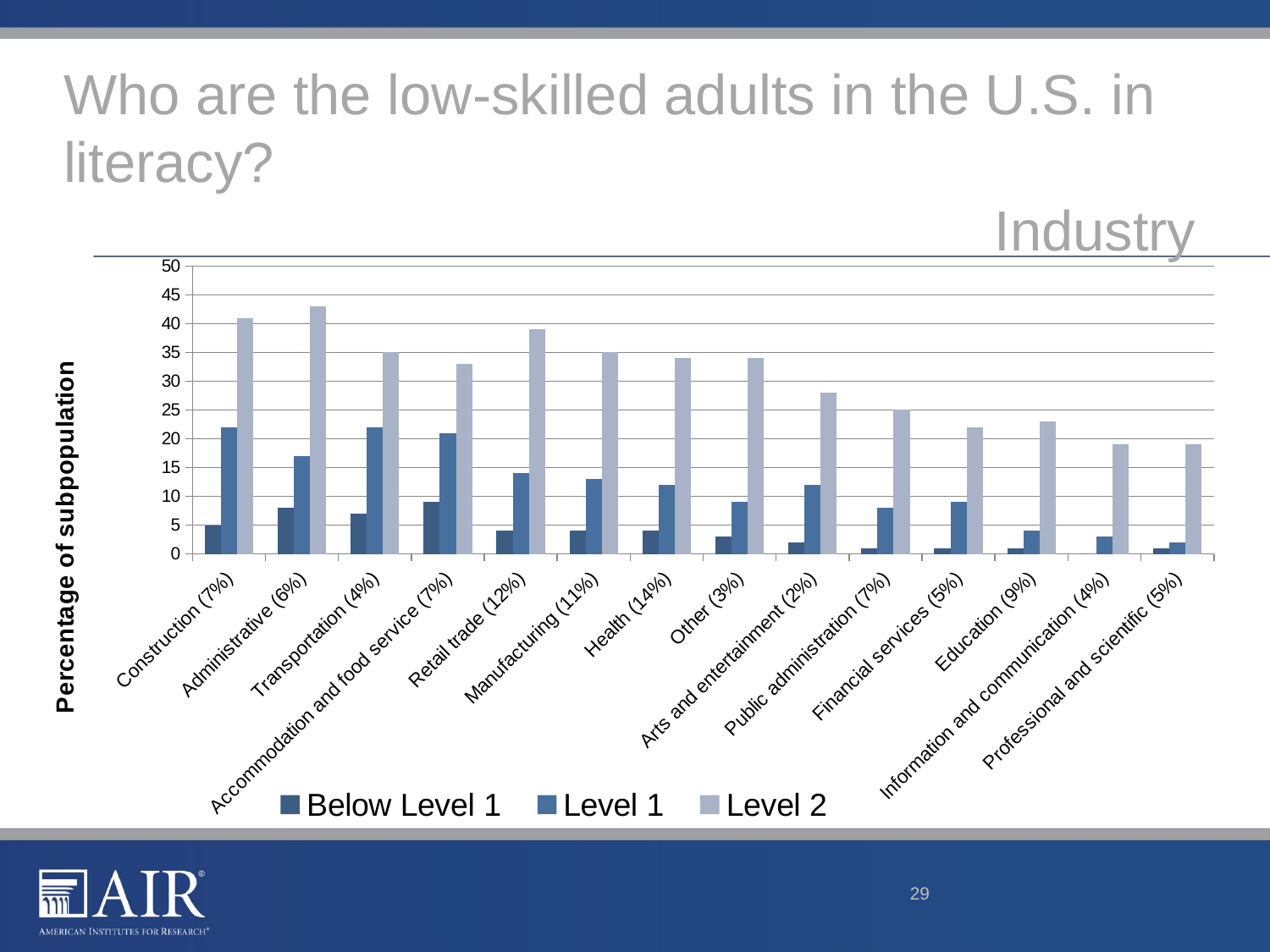
What is the label of the y axis? Percentage of subpopulation Is the Level 1 value for Accommodation and food service (7%) greater or less than 15? greater Which industry has the highest Level 2 value? Administrative (6%) Do the Level 2 values generally rise or fall moving from left to right along the x axis? fall Is the Level 2 value for Public administration (7%) greater or less than 30? less Which is larger: the Level 1 value for Retail trade (12%) or the Level 1 value for Other (3%)? Retail trade (12%) How many series does the legend list? 3 Which is larger: the Level 2 value for Construction (7%) or the Level 2 value for Public administration (7%)? Construction (7%) Is the Level 2 value for Professional and scientific (5%) greater or less than 25? less What kind of chart is shown on the slide? bar chart How many industry categories are shown on the x axis? 14